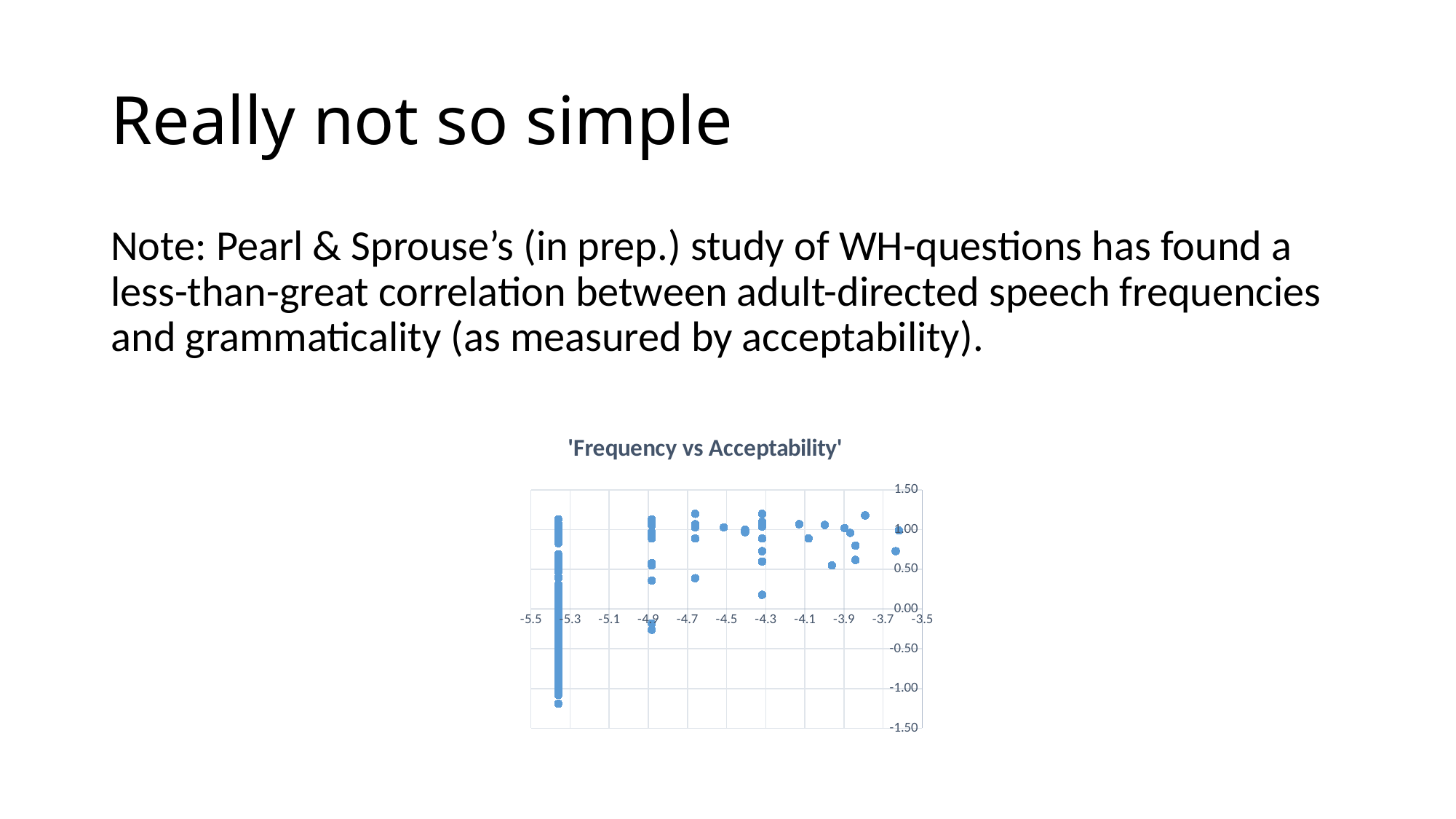
What is the title of the chart? 'Frequency vs Acceptability' Is the rightmost plotted point on the chart at an x value greater or less than -3.9? greater Is the lowest plotted point on the chart greater or less than -1.00 on the vertical axis? less Is the leftmost column of points on the chart located at an x value greater or less than -5.1? less What kind of chart is shown on the slide? scatter chart What is the highest value shown on the vertical axis of the chart? 1.50